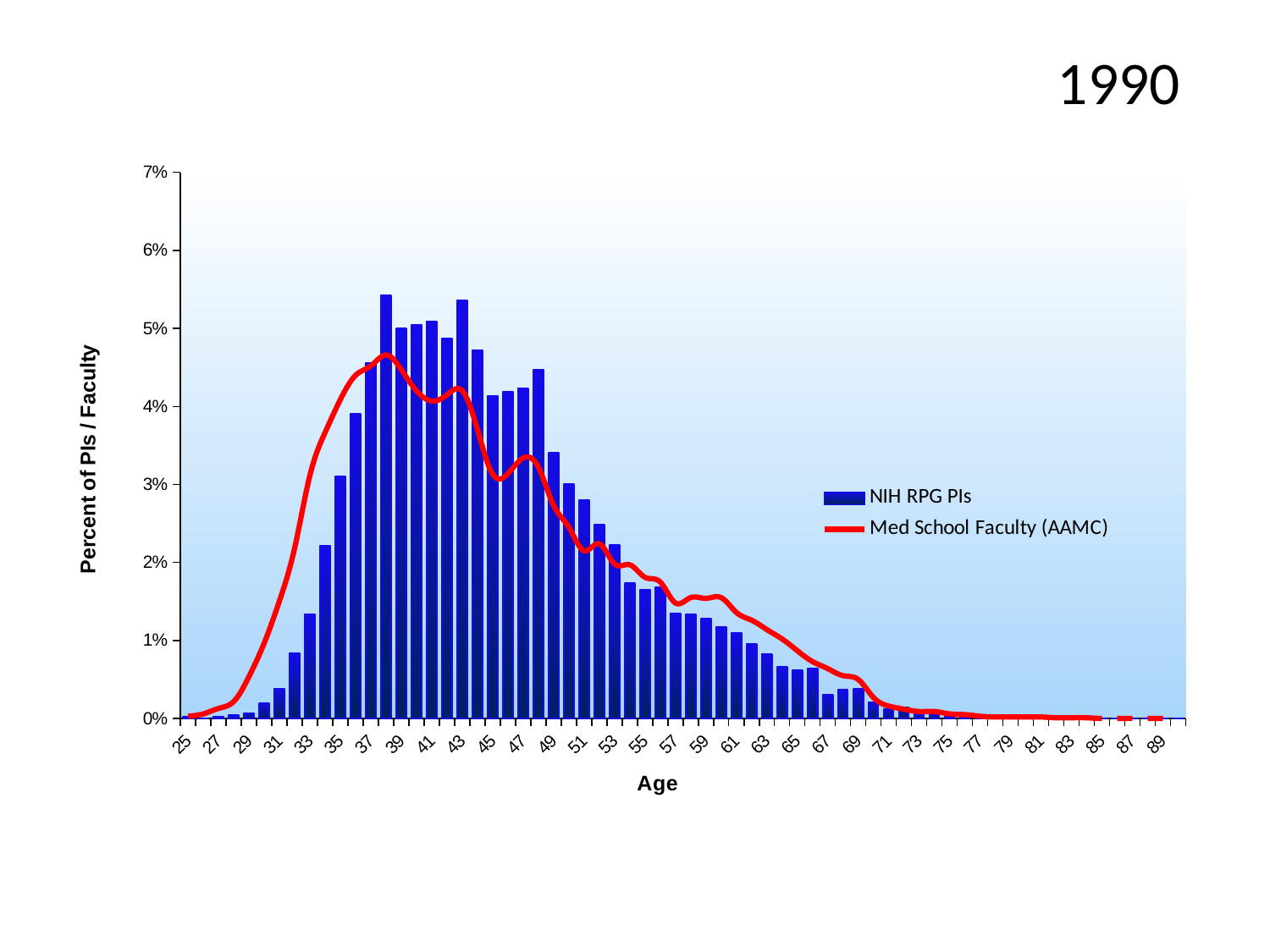
Is the NIH RPG PIs value at age 53 greater or less than 3%? less Which series is drawn as a red line? Med School Faculty (AAMC) Is the NIH RPG PIs value at age 33 greater or less than 2%? less Is the Med School Faculty (AAMC) value at age 65 greater or less than 1%? less Do the NIH RPG PIs values rise or fall from age 49 to age 69? Fall What kind of chart is shown on the slide? A combined bar and line chart Which is larger for NIH RPG PIs: the value at age 35 or the value at age 55? Age 35 What is the title of the x axis? Age How many series does the legend list? 2 Do the NIH RPG PIs values rise or fall from age 29 to age 37? Rise